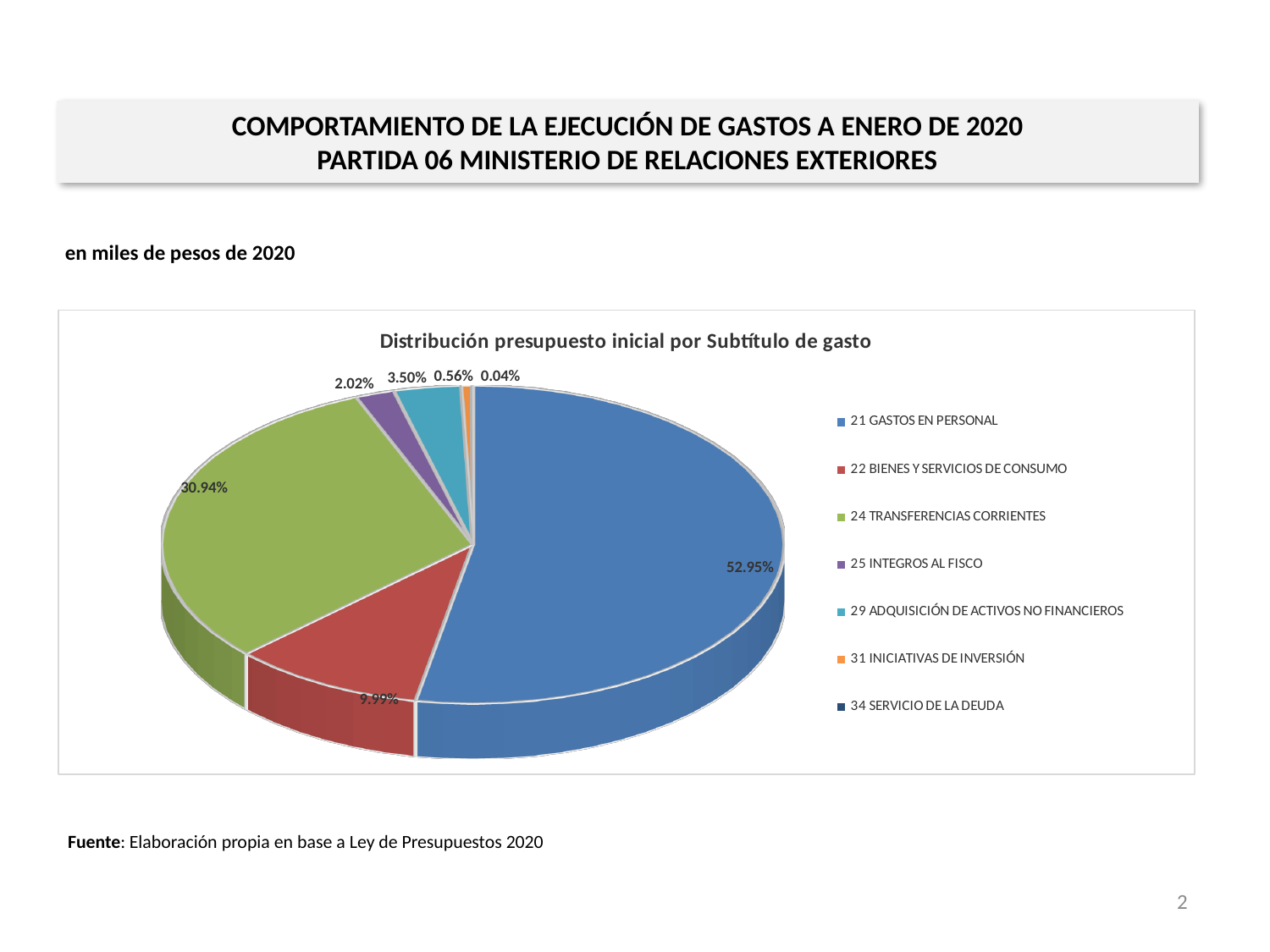
What share of the pie does 24 TRANSFERENCIAS CORRIENTES represent? 30.94% What share of the pie does 21 GASTOS EN PERSONAL represent? 52.95% What is the difference in percentage points between the shares of 21 GASTOS EN PERSONAL and 24 TRANSFERENCIAS CORRIENTES? 22.01 percentage points What kind of chart is shown on the slide? Pie chart Which category has the largest share of the pie? 21 GASTOS EN PERSONAL What share of the pie does 29 ADQUISICIÓN DE ACTIVOS NO FINANCIEROS represent? 3.50% What share of the pie does 22 BIENES Y SERVICIOS DE CONSUMO represent? 9.99% What share of the pie does 34 SERVICIO DE LA DEUDA represent? 0.04% Which category has the smallest share of the pie? 34 SERVICIO DE LA DEUDA What is the title of the chart? Distribución presupuesto inicial por Subtítulo de gasto Which has a larger share, 25 INTEGROS AL FISCO or 29 ADQUISICIÓN DE ACTIVOS NO FINANCIEROS? 29 ADQUISICIÓN DE ACTIVOS NO FINANCIEROS How many categories does the legend of the pie chart list? 7